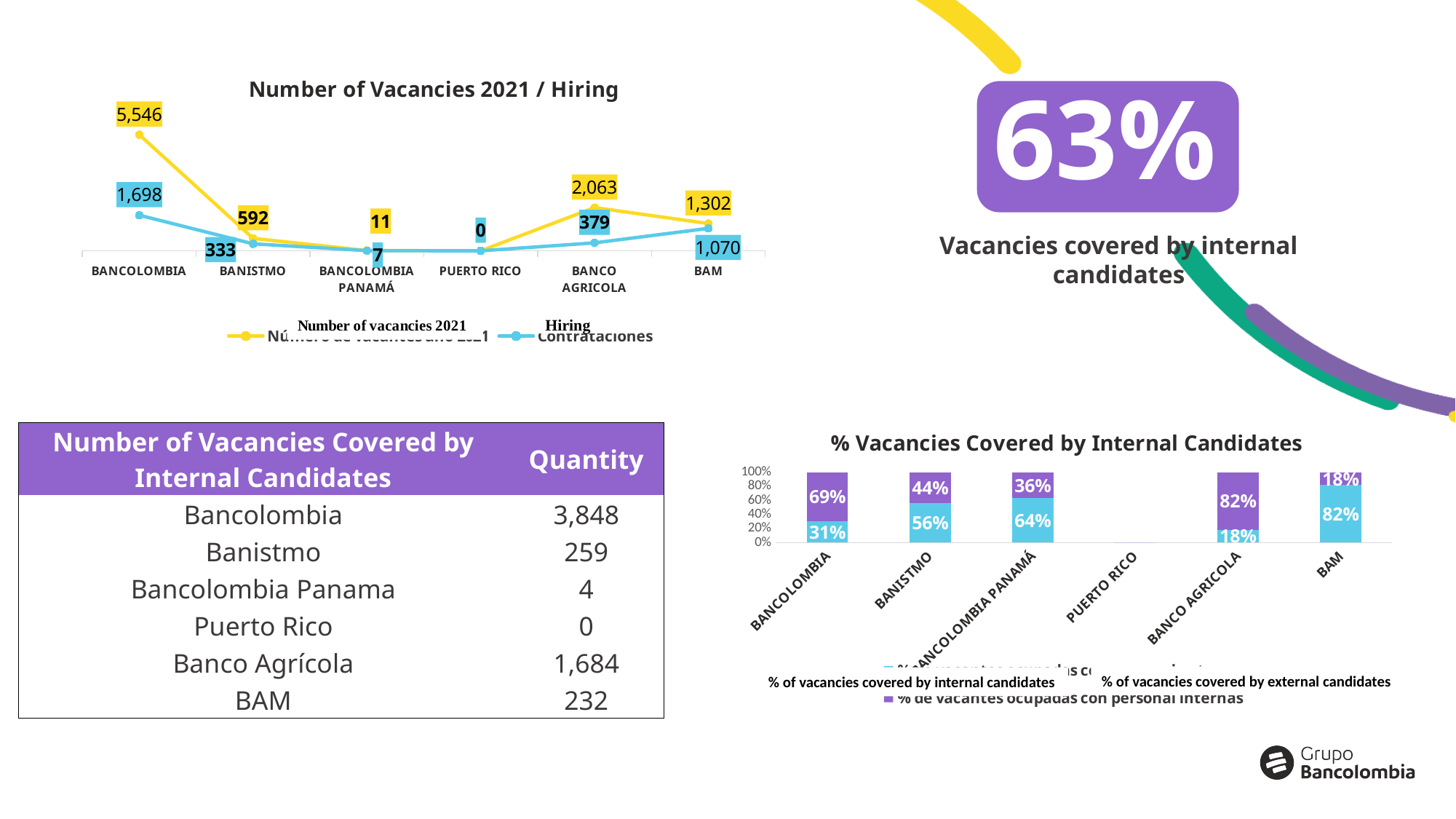
In the 'Number of Vacancies 2021 / Hiring' chart, which has the larger Hiring value, Bancolombia or BAM? Bancolombia In the '% Vacancies Covered by Internal Candidates' chart, what is the value of the blue segment for BAM? 82% How many series does the legend of the 'Number of Vacancies 2021 / Hiring' chart list? 2 How many categories are shown on the x axis of the 'Number of Vacancies 2021 / Hiring' chart? 6 In the 'Number of Vacancies 2021 / Hiring' chart, what is the difference between the number of vacancies 2021 and Hiring for Banco Agricola? 1,684 In the '% Vacancies Covered by Internal Candidates' chart, what is the value of the purple segment for Banco Agricola? 82% In the 'Number of Vacancies 2021 / Hiring' chart, what is the Hiring value for BAM? 1,070 In the 'Number of Vacancies 2021 / Hiring' chart, what is the number of vacancies 2021 for Bancolombia? 5,546 In the 'Number of Vacancies 2021 / Hiring' chart, what is the Hiring value for Banistmo? 333 What kind of chart is the 'Number of Vacancies 2021 / Hiring' chart? Line chart In the 'Number of Vacancies 2021 / Hiring' chart, which category has the highest number of vacancies 2021? Bancolombia What kind of chart is the '% Vacancies Covered by Internal Candidates' chart? Stacked bar chart